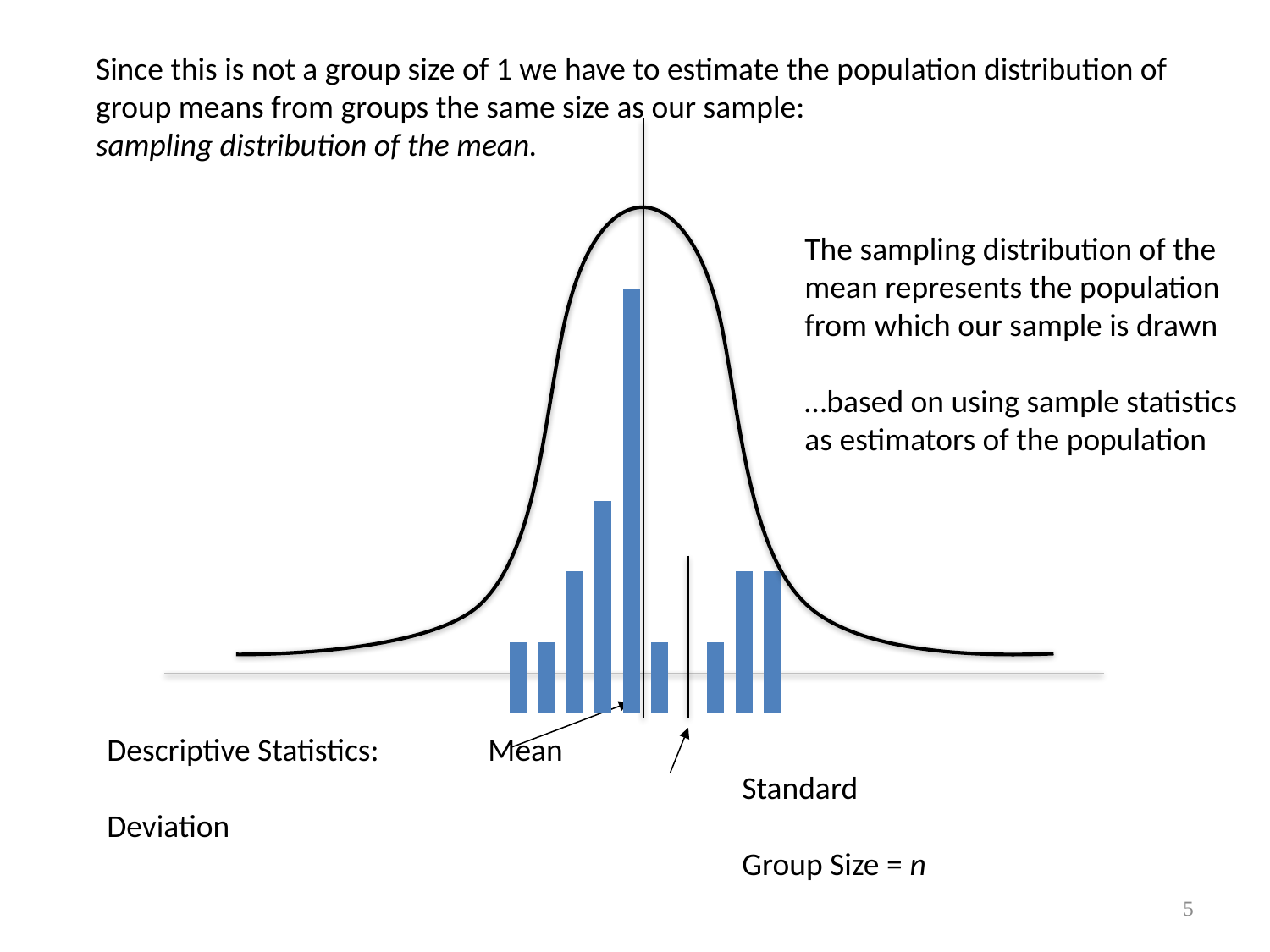
Which bar in the chart is the tallest? the fifth bar from the left What kind of chart is shown on the slide? bar chart What colour are the bars in the chart? blue Which is taller, the fourth bar from the left or the third bar from the left? the fourth bar from the left Which is taller, the fifth bar from the left or the sixth bar from the left? the fifth bar from the left What shape is the black curve drawn over the bars? a bell-shaped (normal) curve How many blue bars are plotted in the chart? 9